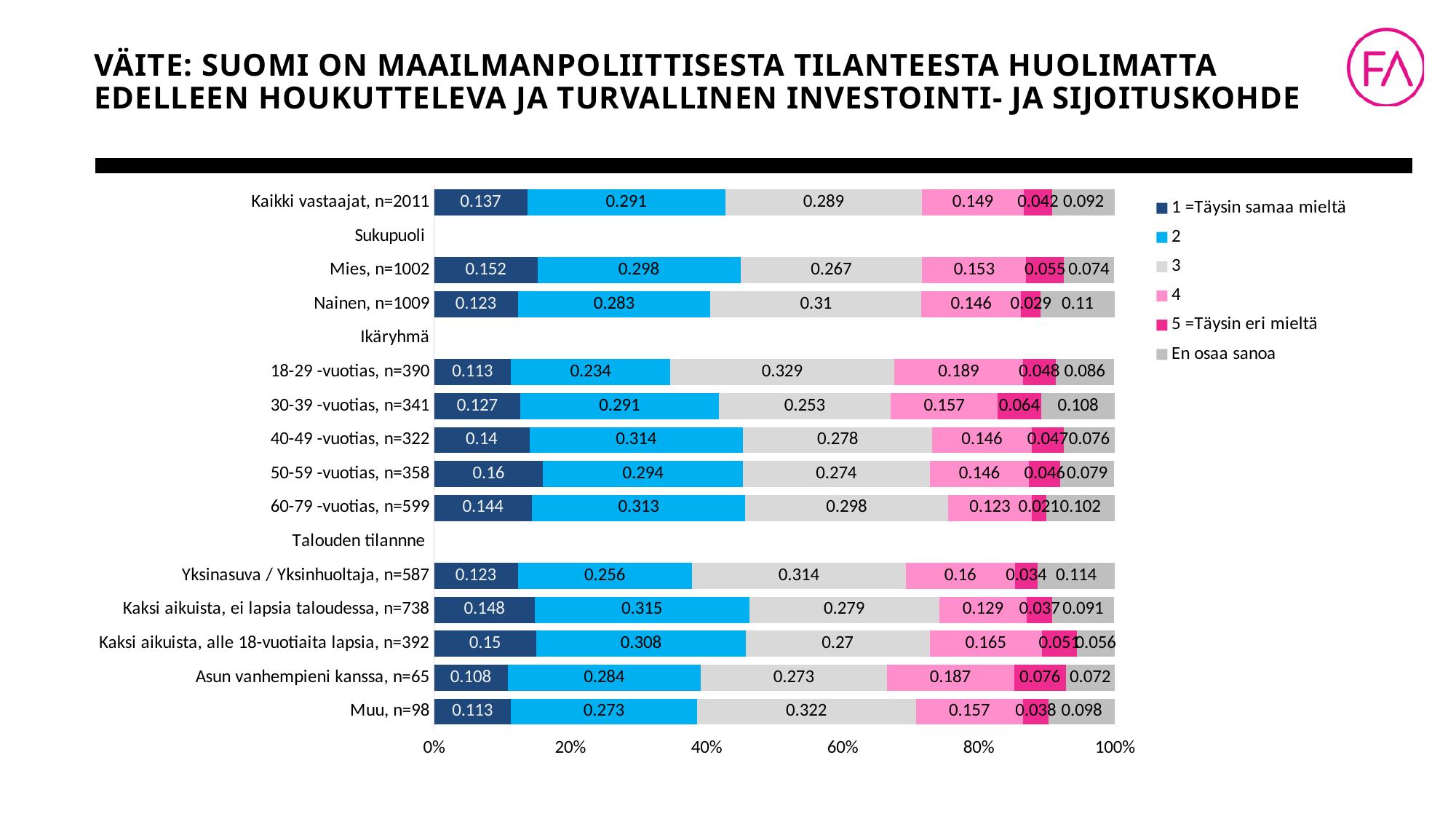
What is the value of series "3" for Mies, n=1002? 0.267 What is the value of series "4" for Asun vanhempieni kanssa, n=65? 0.187 Which category has the highest value for "1 =Täysin samaa mieltä"? 50-59 -vuotias, n=358 How many series does the legend list? 6 What is the value of "5 =Täysin eri mieltä" for 60-79 -vuotias, n=599? 0.021 Which has the larger value for series "2": 40-49 -vuotias, n=322 or 18-29 -vuotias, n=390? 40-49 -vuotias, n=322 What kind of chart is shown on the slide? Stacked bar chart What is the legend label for the series shown in dark pink? 5 =Täysin eri mieltä How many categories have bars plotted in the chart? 13 Which category has the lowest value for "1 =Täysin samaa mieltä"? Asun vanhempieni kanssa, n=65 What is the difference between the "1 =Täysin samaa mieltä" values for Mies, n=1002 and Nainen, n=1009? 0.029 What is the value of "1 =Täysin samaa mieltä" for Kaikki vastaajat, n=2011? 0.137